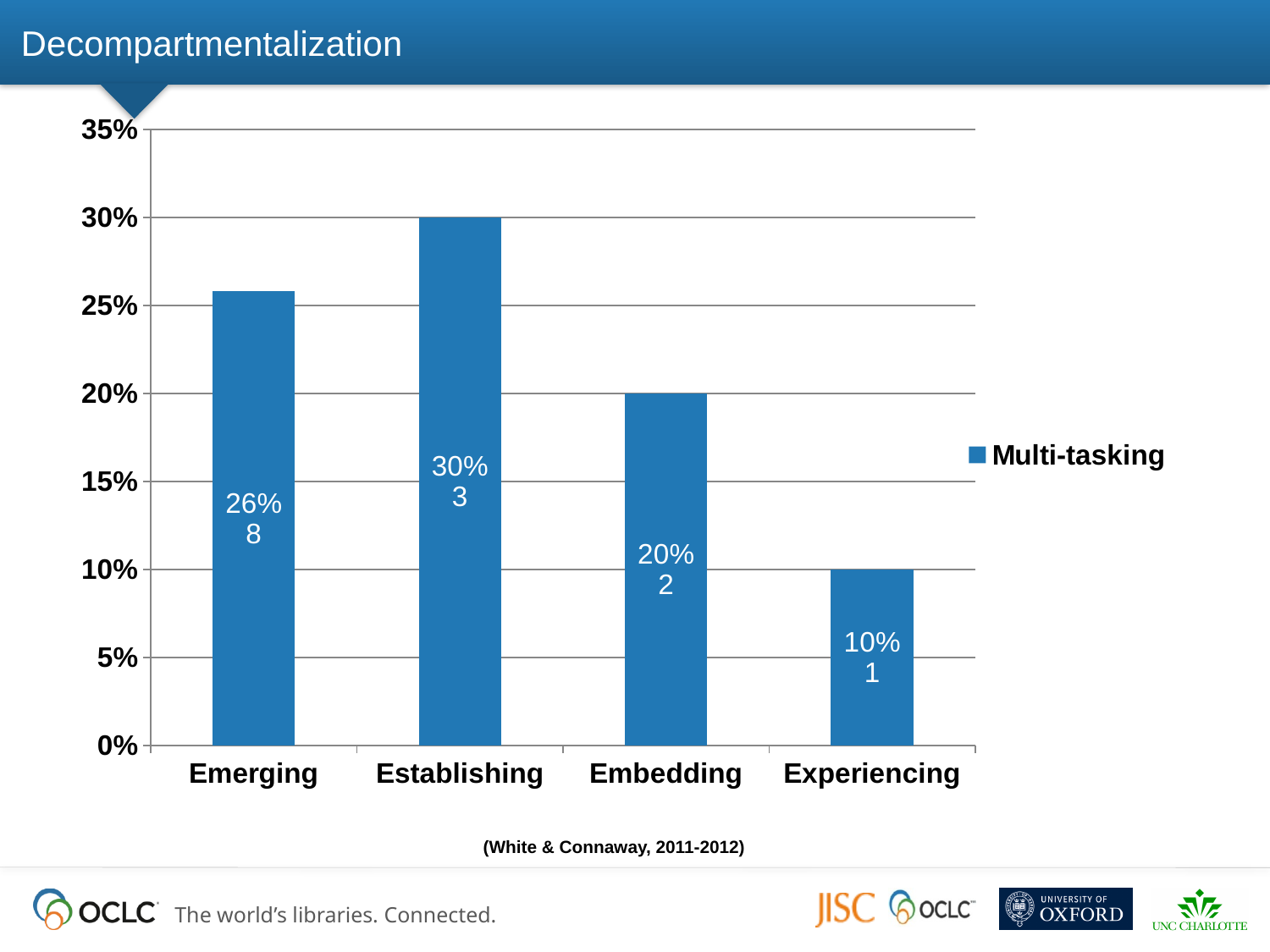
What is the difference in percentage points between Establishing and Embedding? 10% Which category has the highest percentage? Establishing How many categories are shown on the x axis? 4 What percentage is shown for Establishing? 30% What percentage is shown for Emerging? 26% Which category has the lowest percentage? Experiencing What is the name of the series in the legend? Multi-tasking Which is larger, the value for Emerging or the value for Embedding? Emerging How many series does the legend list? 1 What kind of chart is shown on the slide? Bar chart What count is printed on the Emerging bar? 8 What count is printed on the Experiencing bar? 1